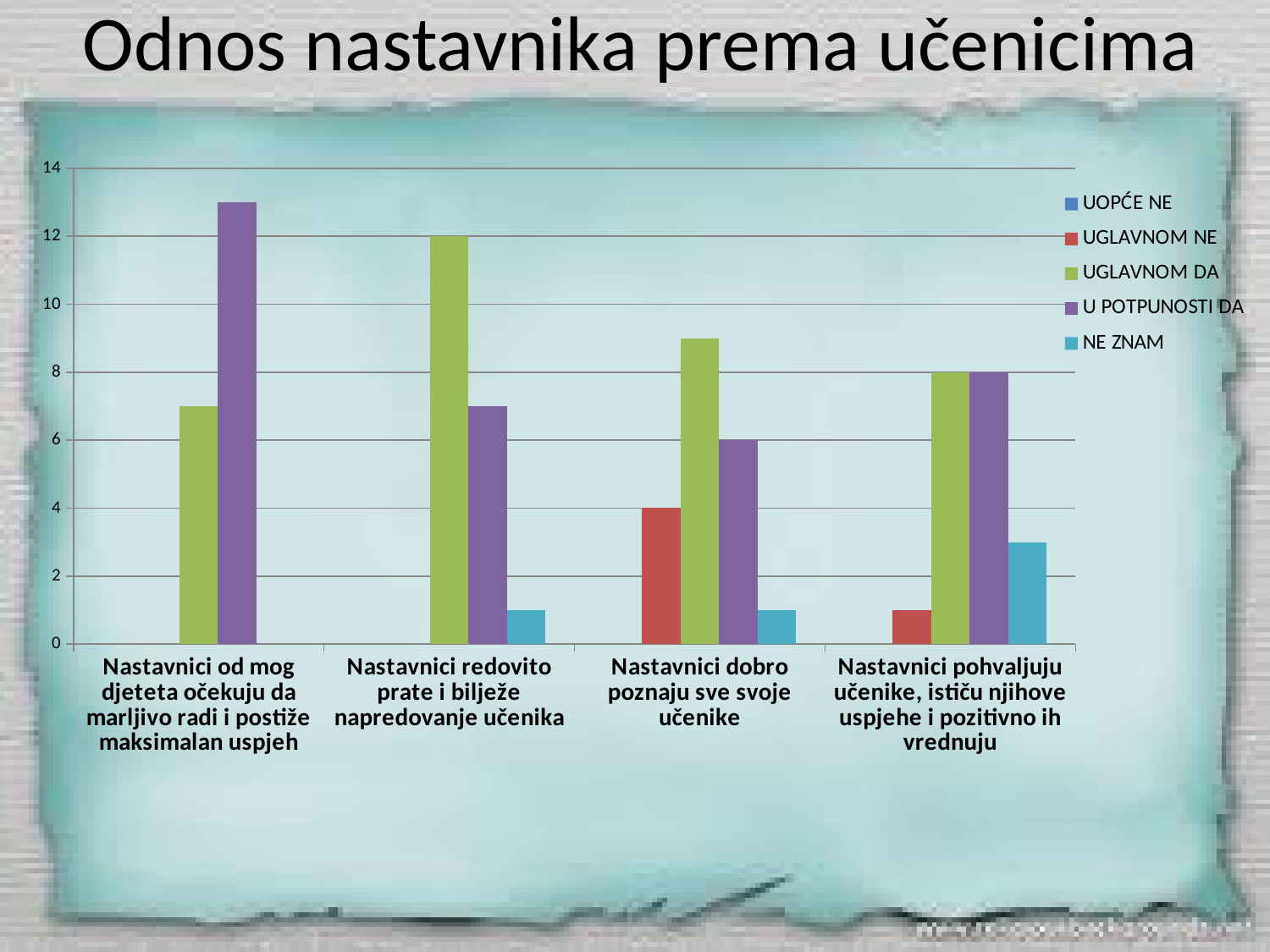
What is the difference between the UGLAVNOM DA value for "Nastavnici redovito prate i bilježe napredovanje učenika" and the UGLAVNOM DA value for "Nastavnici pohvaljuju učenike, ističu njihove uspjehe i pozitivno ih vrednuju"? 4 What is the value of UGLAVNOM NE for "Nastavnici dobro poznaju sve svoje učenike"? 4 What is the value of UGLAVNOM DA for "Nastavnici pohvaljuju učenike, ističu njihove uspjehe i pozitivno ih vrednuju"? 8 What is the value of UGLAVNOM DA for "Nastavnici redovito prate i bilježe napredovanje učenika"? 12 How many categories are shown on the x axis? 4 What kind of chart is shown on the slide? bar chart How many series does the legend list? 5 What is the value of U POTPUNOSTI DA for "Nastavnici dobro poznaju sve svoje učenike"? 6 Which category has the highest U POTPUNOSTI DA value? Nastavnici od mog djeteta očekuju da marljivo radi i postiže maksimalan uspjeh Is the value of U POTPUNOSTI DA for "Nastavnici od mog djeteta očekuju da marljivo radi i postiže maksimalan uspjeh" greater or less than 12? greater For "Nastavnici redovito prate i bilježe napredovanje učenika", which is larger: UGLAVNOM DA or U POTPUNOSTI DA? UGLAVNOM DA Is the value of NE ZNAM for "Nastavnici pohvaljuju učenike, ističu njihove uspjehe i pozitivno ih vrednuju" greater or less than 4? less